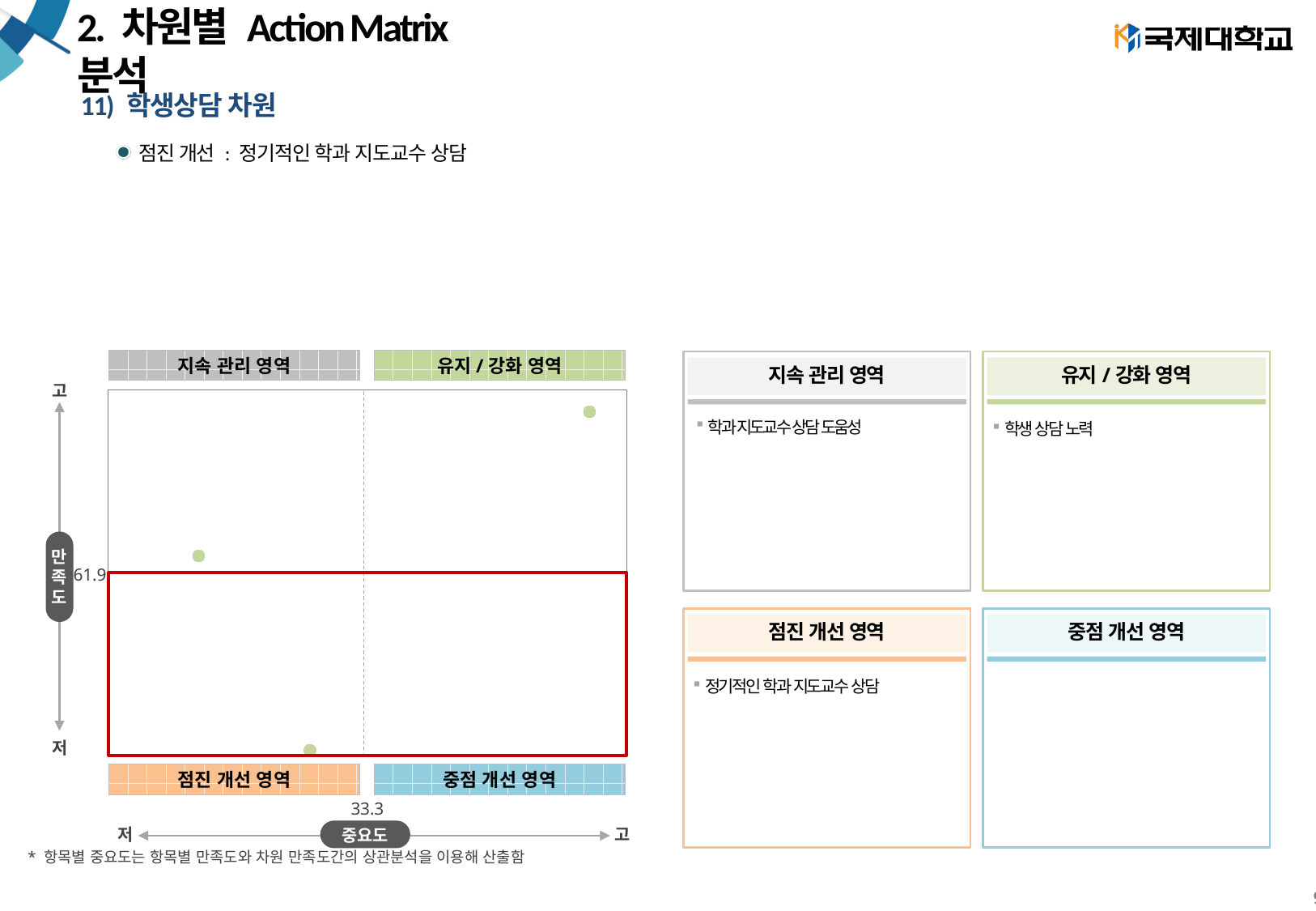
Which quadrant of the action matrix contains no data points? 중점 개선 영역 Which quadrant contains the point with the highest satisfaction value? 유지 / 강화 영역 What value marks the horizontal reference line on the 만족도 (satisfaction) axis? 61.9 Is the satisfaction value of the point in the 유지 / 강화 영역 quadrant greater or less than 61.9? greater Is the importance value of the point in the 점진 개선 영역 quadrant greater or less than 33.3? less What value marks the vertical reference line on the 중요도 (importance) axis? 33.3 How many data points are plotted in the action matrix chart? 3 What kind of chart is shown on the left of the slide? scatter chart How many data points fall in the 점진 개선 영역 (bottom-left) quadrant? 1 How many data points lie above the 61.9 satisfaction reference line? 2 Which quadrant contains the point with the lowest satisfaction value? 점진 개선 영역 What label is given to the vertical axis of the action matrix? 만족도